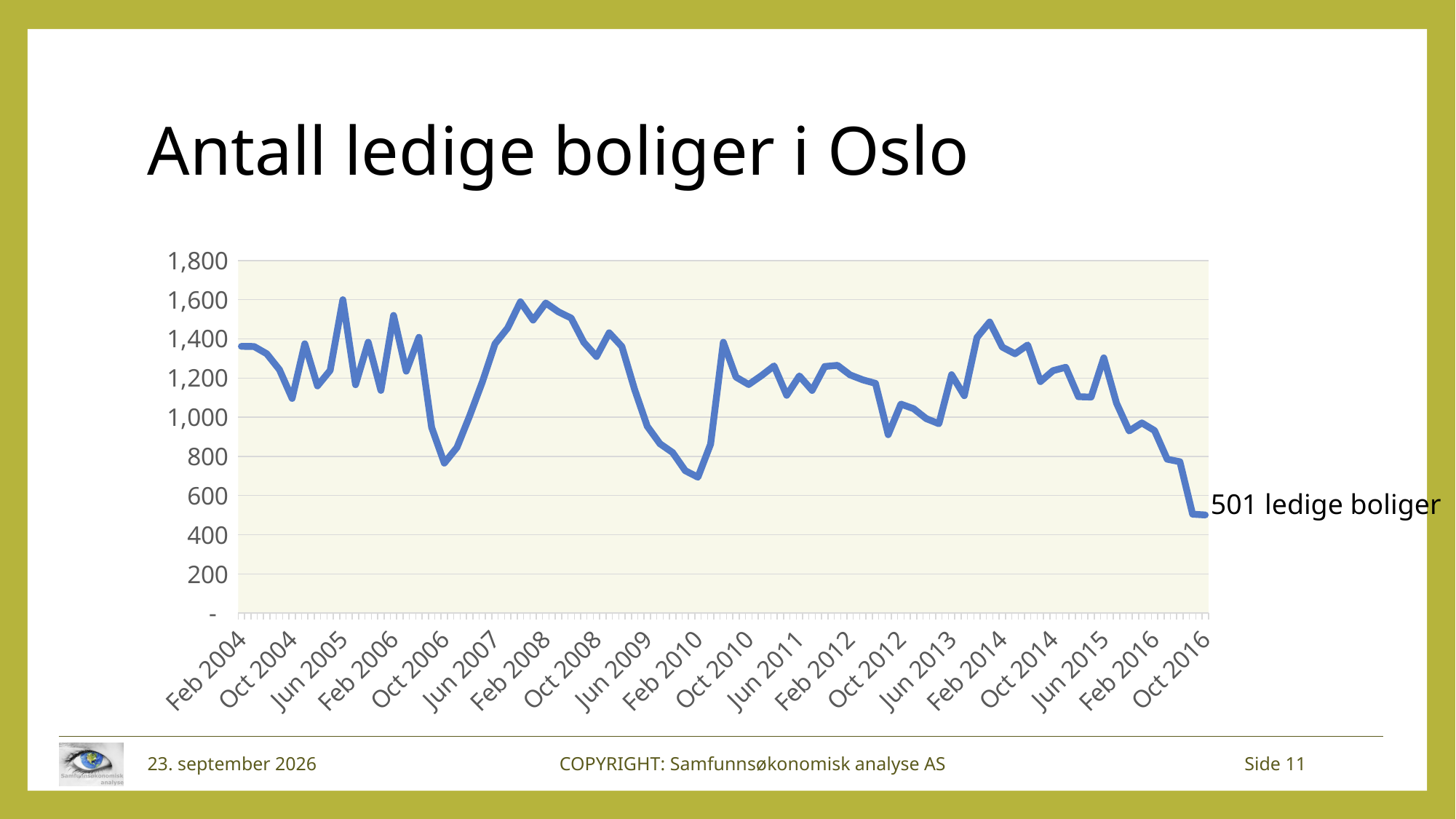
What value is labelled at the end of the line, for Oct 2016? 501 ledige boliger Is the value for Feb 2008 greater or less than 1,400? greater Is the value for Feb 2010 greater or less than 800? less Which is larger, the value for Oct 2006 or the value for Feb 2008? Feb 2008 What kind of chart is shown on the slide? line chart Does the line rise or fall between Feb 2016 and Oct 2016? fall Which is larger, the value for Feb 2004 or the value for Oct 2016? Feb 2004 Is the value for Oct 2006 greater or less than 1,000? less What is the highest value shown on the y axis? 1,800 At which point on the x axis is the number of vacant homes lowest? Oct 2016 What is the title of the chart? Antall ledige boliger i Oslo